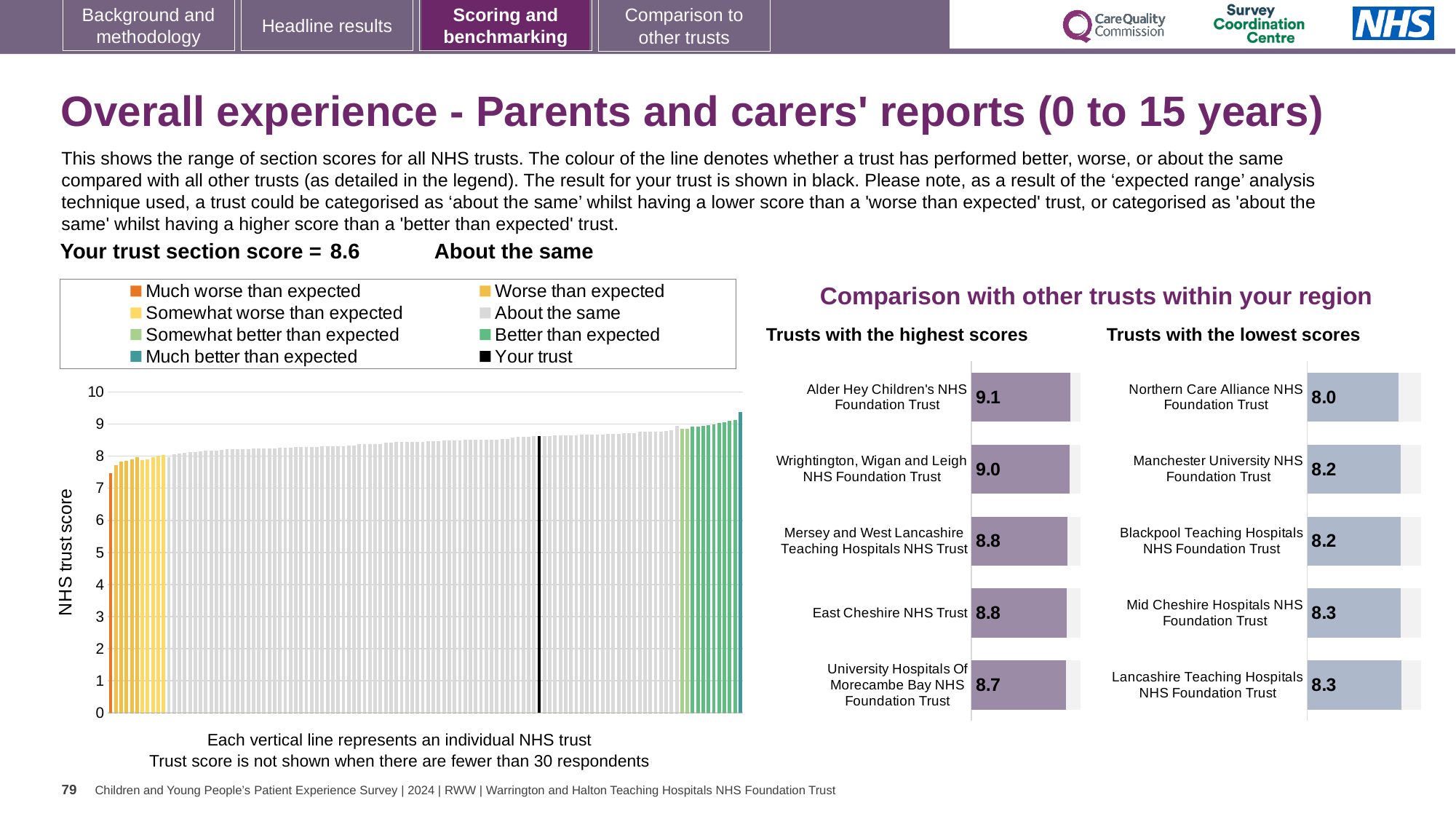
Which has the higher score: Wrightington, Wigan and Leigh NHS Foundation Trust in the highest scores chart, or Manchester University NHS Foundation Trust in the lowest scores chart? Wrightington, Wigan and Leigh NHS Foundation Trust In the main 'NHS trust score' chart on the left, is the value for the lowest (orange) trust greater or less than 8? less In the 'Trusts with the highest scores' chart, what is the difference between the scores of Alder Hey Children's NHS Foundation Trust and University Hospitals Of Morecambe Bay NHS Foundation Trust? 0.4 In the 'Trusts with the highest scores' chart, what is the score for Alder Hey Children's NHS Foundation Trust? 9.1 In the 'Trusts with the highest scores' chart, which trust has the highest score? Alder Hey Children's NHS Foundation Trust What kind of chart is the main 'NHS trust score' chart on the left? bar chart How many entries does the legend of the main 'NHS trust score' chart on the left list? 8 In the 'Trusts with the highest scores' chart, what is the score for University Hospitals Of Morecambe Bay NHS Foundation Trust? 8.7 In the 'Trusts with the lowest scores' chart, what is the score for Mid Cheshire Hospitals NHS Foundation Trust? 8.3 How many trusts are listed in the 'Trusts with the lowest scores' chart? 5 In the 'Trusts with the lowest scores' chart, which trust has the lowest score? Northern Care Alliance NHS Foundation Trust In the 'Trusts with the lowest scores' chart, what is the score for Northern Care Alliance NHS Foundation Trust? 8.0